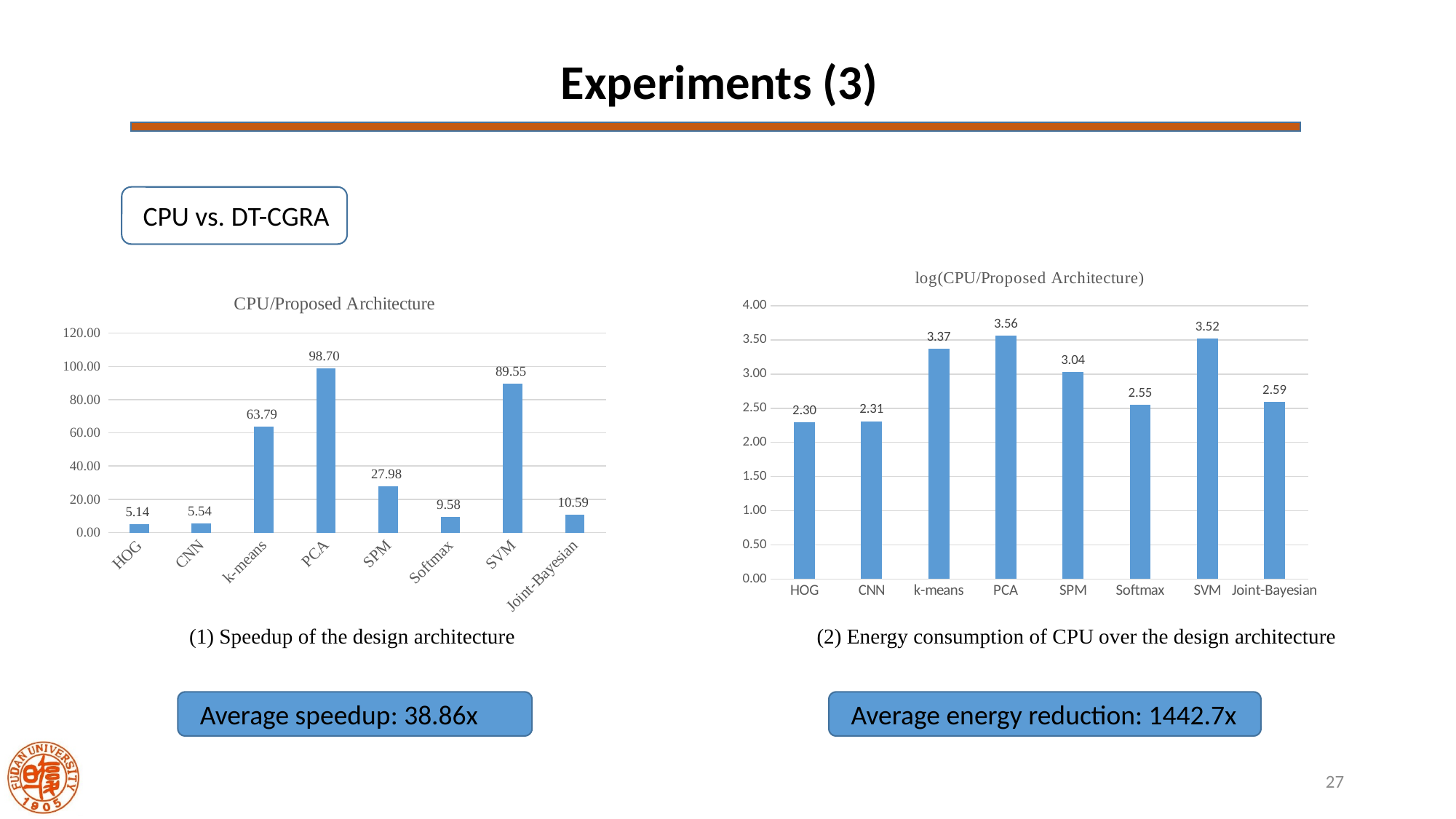
In the chart titled "CPU/Proposed Architecture", what is the difference between the values for PCA and SVM? 9.15 What kind of chart is the chart titled "CPU/Proposed Architecture"? Bar chart In the chart titled "CPU/Proposed Architecture", which is larger, the value for k-means or the value for SPM? k-means In the chart titled "CPU/Proposed Architecture", which category has the highest value? PCA In the chart titled "CPU/Proposed Architecture", what is the value for PCA? 98.70 In the chart titled "log(CPU/Proposed Architecture)", what is the difference between the values for k-means and Softmax? 0.82 In the chart titled "log(CPU/Proposed Architecture)", what is the value for k-means? 3.37 In the chart titled "CPU/Proposed Architecture", which category has the lowest value? HOG How many categories are shown in the chart titled "log(CPU/Proposed Architecture)"? 8 In the chart titled "log(CPU/Proposed Architecture)", which category has the highest value? PCA In the chart titled "CPU/Proposed Architecture", what is the value for SPM? 27.98 In the chart titled "log(CPU/Proposed Architecture)", what is the value for Joint-Bayesian? 2.59